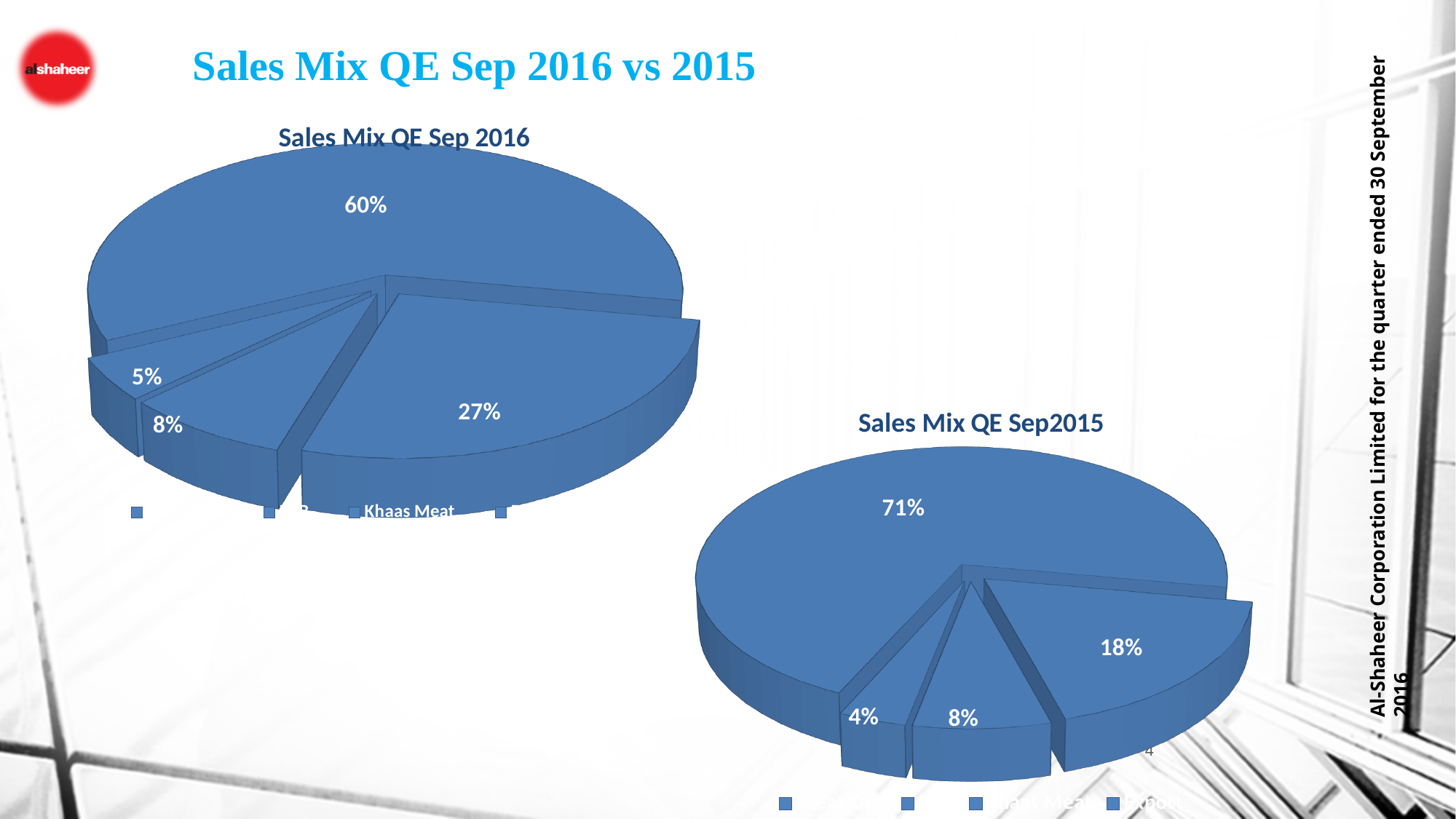
In the 'Sales Mix QE Sep2015' chart, what is the smallest percentage shown on any slice? 4% What kind of chart is the 'Sales Mix QE Sep 2016' chart? pie chart How many slices does the 'Sales Mix QE Sep 2016' pie chart have? 4 In the 'Sales Mix QE Sep2015' chart, what is the largest percentage shown on any slice? 71% How many legend entries are shown below the 'Sales Mix QE Sep 2016' chart? 4 In the 'Sales Mix QE Sep 2016' chart, what is the difference between the largest slice (60%) and the second-largest slice (27%)? 33% How many slices does the 'Sales Mix QE Sep2015' pie chart have? 4 In the 'Sales Mix QE Sep2015' chart, what is the difference between the largest slice (71%) and the second-largest slice (18%)? 53% In the 'Sales Mix QE Sep 2016' chart, what is the smallest percentage shown on any slice? 5% In the 'Sales Mix QE Sep 2016' chart, what is the largest percentage shown on any slice? 60% Which chart has the larger biggest slice, 'Sales Mix QE Sep 2016' or 'Sales Mix QE Sep2015'? Sales Mix QE Sep2015 What is the title of the slide? Sales Mix QE Sep 2016 vs 2015